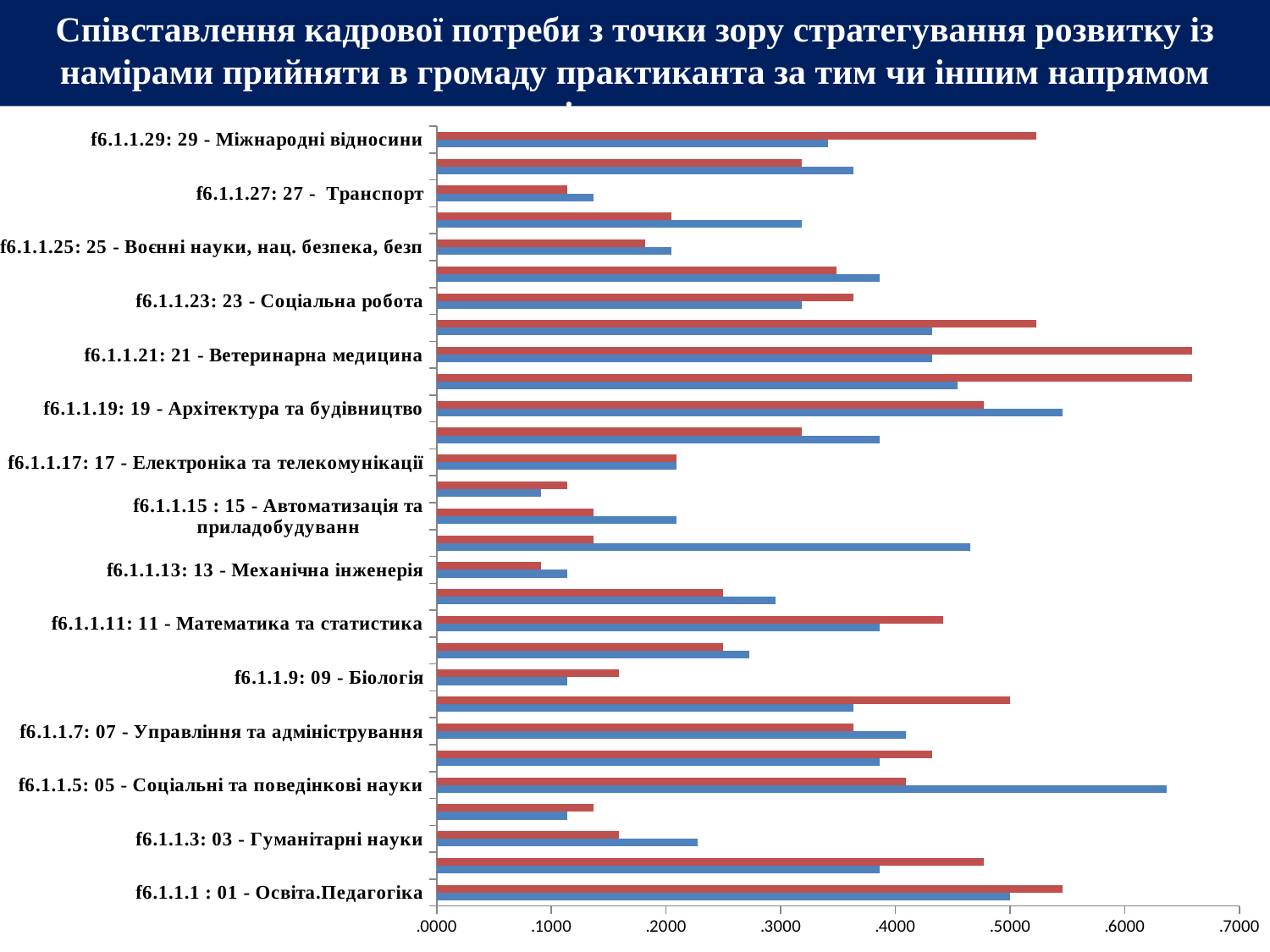
Is the red bar for f6.1.1.29: 29 - Міжнародні відносини greater or less than .5000? greater What kind of chart is shown on the slide? bar chart For f6.1.1.5: 05 - Соціальні та поведінкові науки, which bar is longer, the red one or the blue one? blue Is the blue bar for f6.1.1.27: 27 - Транспорт greater or less than .2000? less Is the blue bar for f6.1.1.5: 05 - Соціальні та поведінкові науки greater or less than .6000? greater Which is longer: the red bar for f6.1.1.29: 29 - Міжнародні відносини or the red bar for f6.1.1.27: 27 - Транспорт? f6.1.1.29: 29 - Міжнародні відносини For f6.1.1.21: 21 - Ветеринарна медицина, which bar is longer, the red one or the blue one? red How many category labels are printed on the vertical axis of the chart? 15